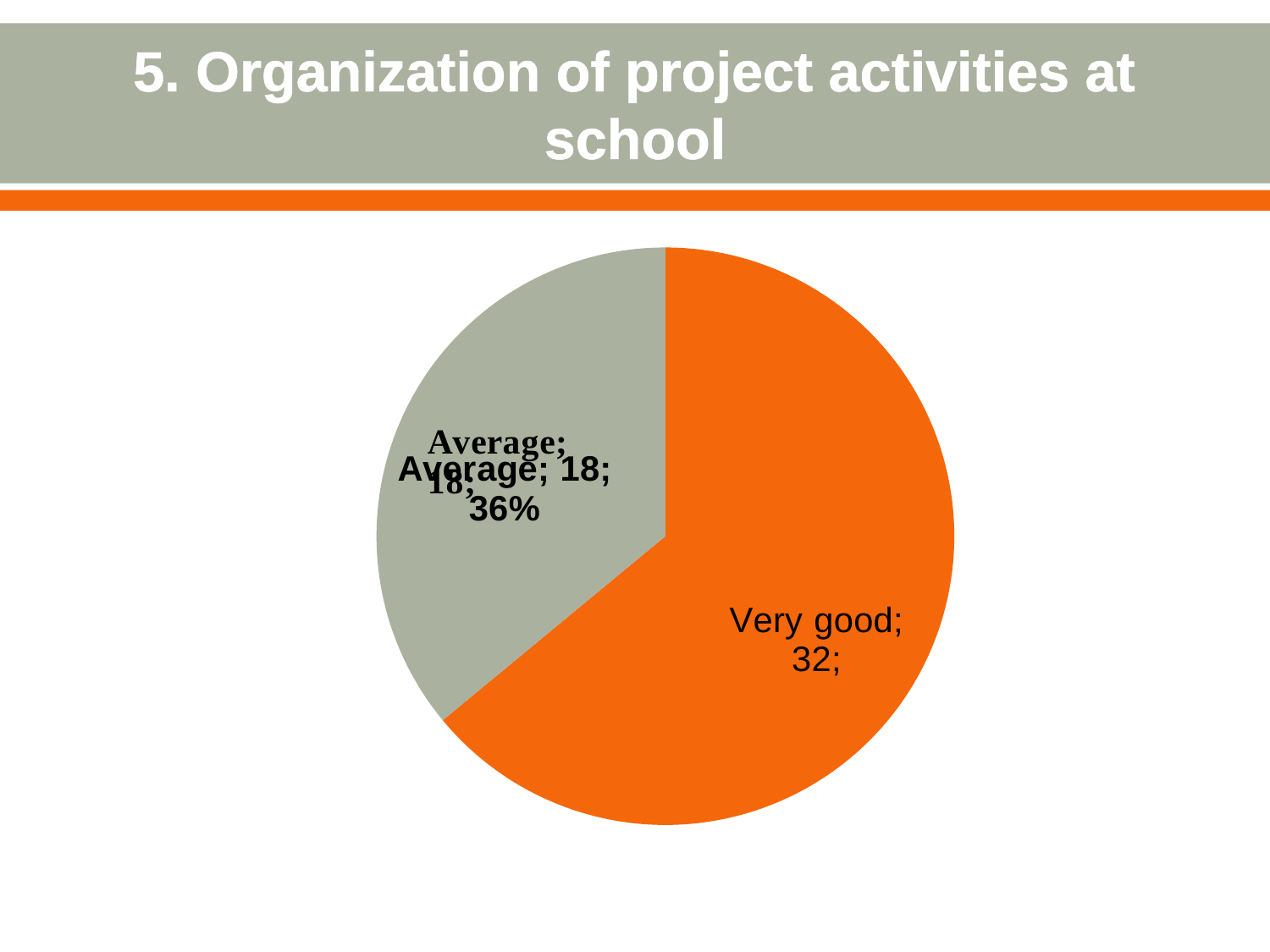
Which slice is the smallest? Average What is the title of the slide containing the pie chart? 5. Organization of project activities at school What kind of chart is shown on the slide? pie chart What is the total of the two slice values? 50 Which slice is the largest? Very good What is the value for the Average slice? 18 What percentage share of the pie does the Average slice have? 36% What colour is the Very good slice? orange What is the difference between the Very good and Average values? 14 What is the value for the Very good slice? 32 How many slices does the pie chart have? 2 Which is larger, the Very good slice or the Average slice? Very good